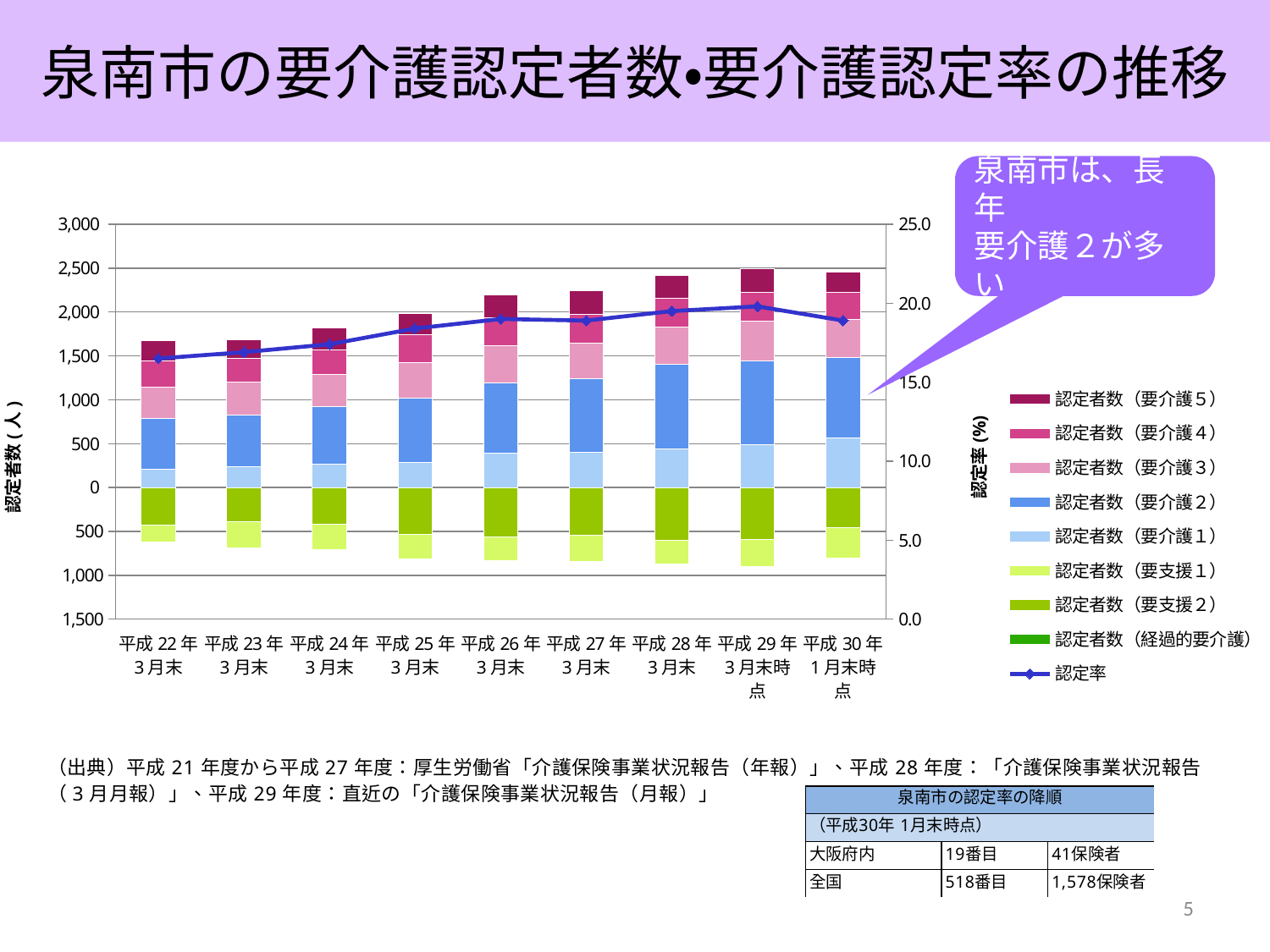
How many series does the chart's legend list? 9 What kind of chart is shown on the slide? Stacked bar chart combined with a line Does the 認定率 line generally rise or fall from 平成22年3月末 to 平成29年3月末時点? rise What is the title of the chart on the slide? 泉南市の要介護認定者数•要介護認定率の推移 Is the 認定率 value at 平成26年3月末 greater or less than 20.0 on the right axis? less Which legend entry is drawn as a line with diamond markers rather than as bars? 認定率 Is the top of the stacked bar at 平成22年3月末 greater or less than 1,500 on the left axis? greater At which time point is the 認定率 line lowest? 平成22年3月末 Is the top of the stacked bar at 平成29年3月末時点 greater or less than 2,000 on the left axis? greater Which is larger, the 認定率 at 平成29年3月末時点 or at 平成30年1月末時点? 平成29年3月末時点 How many time-point categories are shown along the x axis of the chart? 9